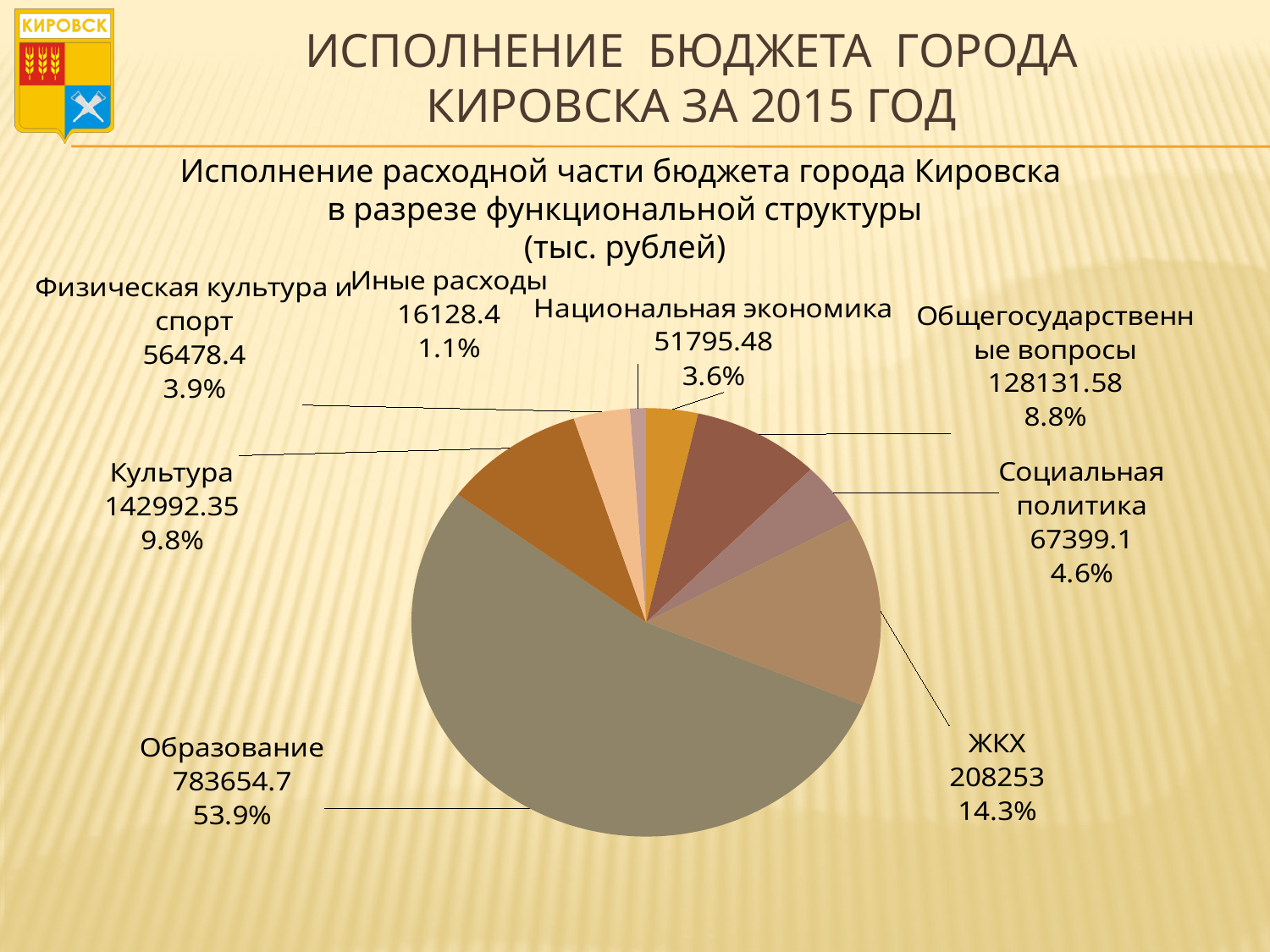
In what units are the values in the chart given, according to the chart title? тыс. рублей What is the value for Физическая культура и спорт? 56478.4 What share of the pie does ЖКХ represent? 14.3% Which is larger, Социальная политика or Национальная экономика? Социальная политика What is the difference between the values for ЖКХ and Культура? 65260.65 What is the value for Образование in the pie chart? 783654.7 What kind of chart is shown on the slide? pie chart Which category has the smallest slice of the pie? Иные расходы Which category has the largest slice of the pie? Образование What share of the pie does Общегосударственные вопросы represent? 8.8% What is the value for Культура? 142992.35 How many slices does the pie chart have? 8